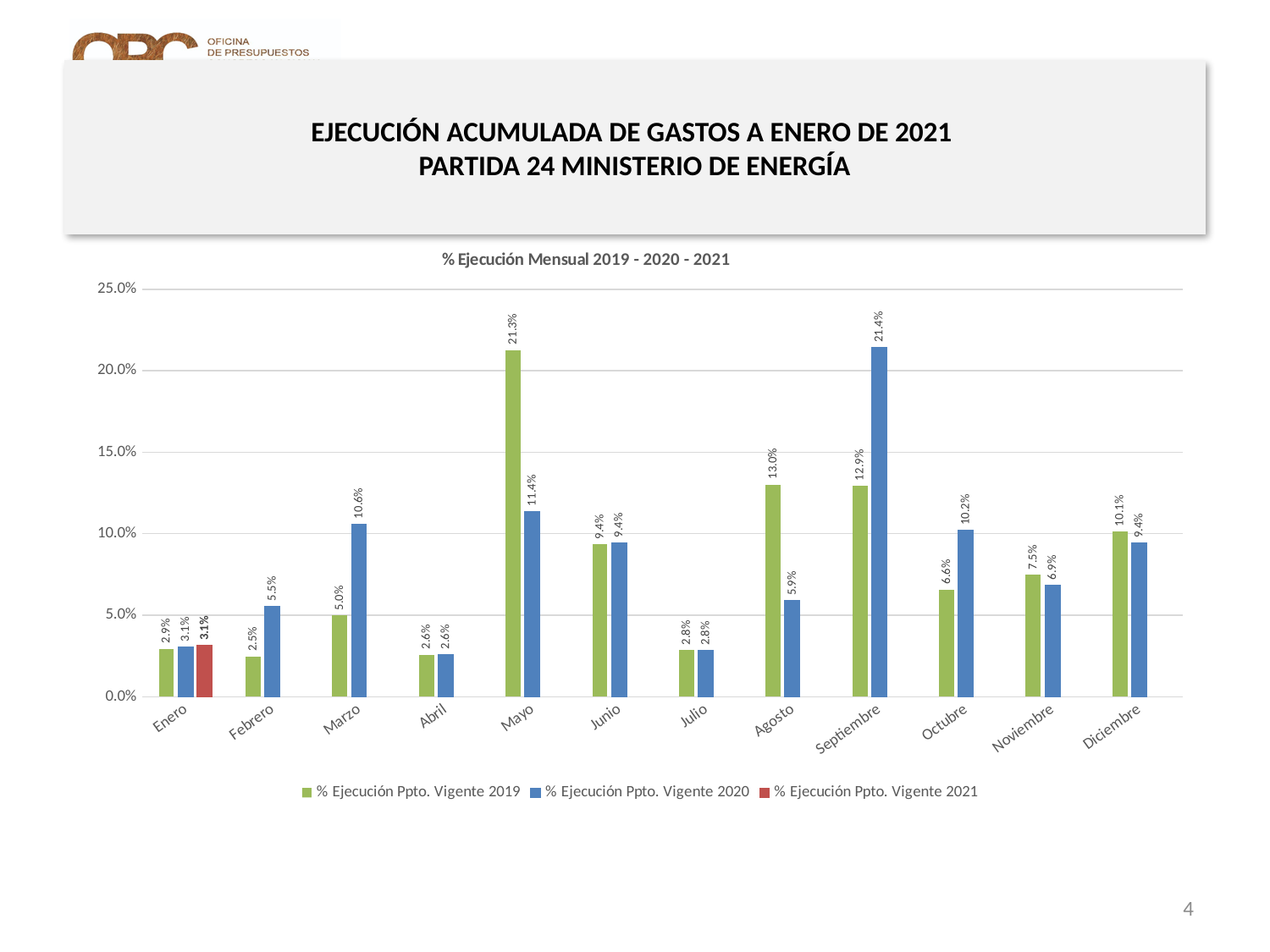
What is the value for % Ejecución Ppto. Vigente 2020 in Septiembre? 21.4% What is the value for % Ejecución Ppto. Vigente 2020 in Marzo? 10.6% Which is larger in Octubre, the 2019 value or the 2020 value? 2020 What kind of chart is shown on the slide? Bar chart In which month is the % Ejecución Ppto. Vigente 2019 series highest? Mayo What is the value for % Ejecución Ppto. Vigente 2019 in Mayo? 21.3% What is the value for % Ejecución Ppto. Vigente 2021 in Enero? 3.1% What is the title of the chart? % Ejecución Mensual 2019 - 2020 - 2021 In which month is the % Ejecución Ppto. Vigente 2019 series lowest? Febrero How many months are shown on the x axis? 12 How many series does the legend list? 3 What is the difference between the 2019 and 2020 values in Agosto? 7.1%